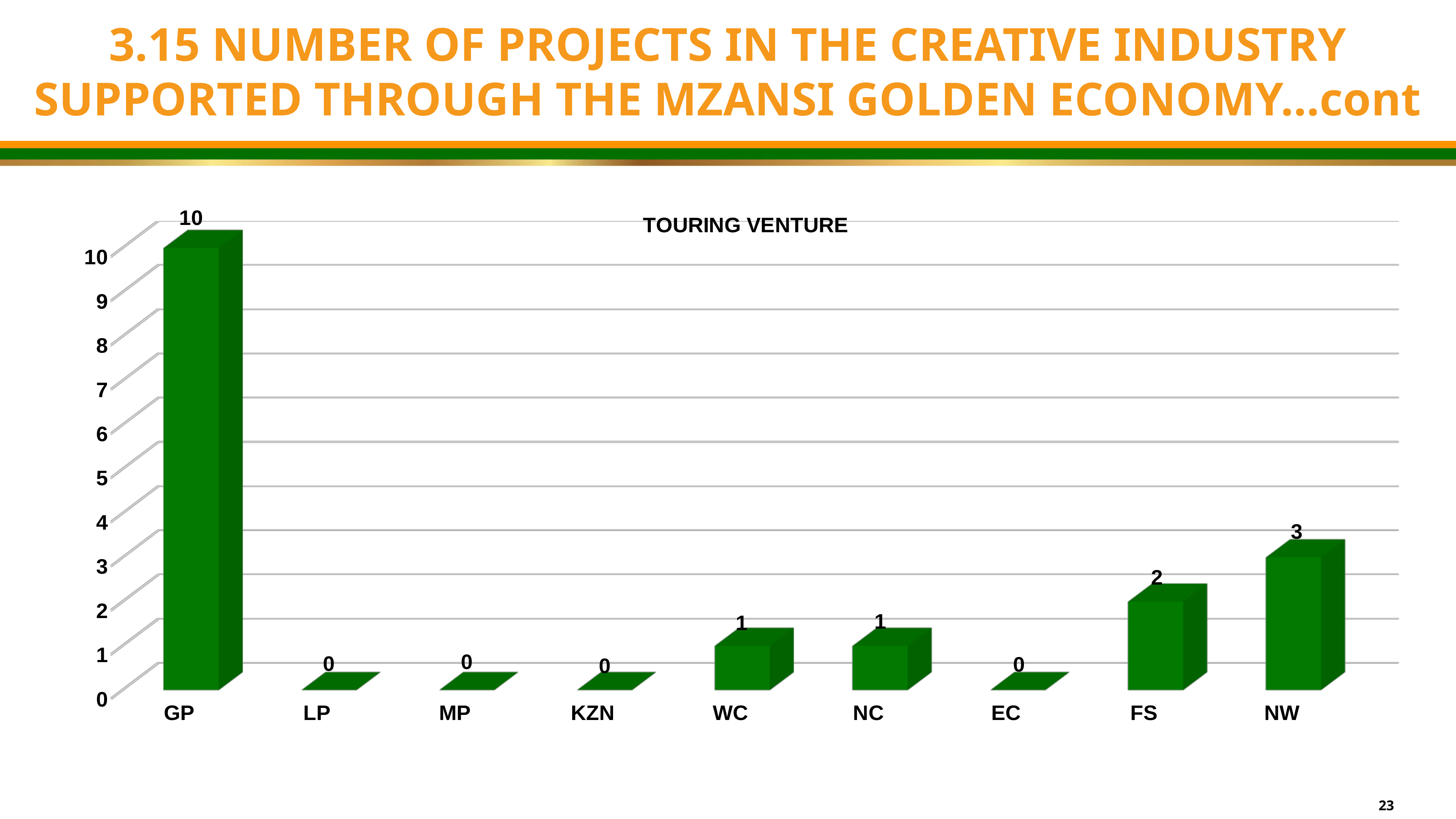
Which is larger, the value for FS or the value for NC? FS What is the value for WC in the Touring Venture chart? 1 How many provinces have a value of 0 in the chart? 4 What is the difference between the values for NW and FS? 1 What is the value for GP in the Touring Venture chart? 10 What is the value for FS in the Touring Venture chart? 2 What is the title of the chart? TOURING VENTURE How many provinces are shown on the x axis of the chart? 9 What is the value for NW in the Touring Venture chart? 3 Which province has the highest number of touring venture projects? GP What is the difference between the values for GP and NW? 7 What kind of chart is shown on the slide? Bar chart